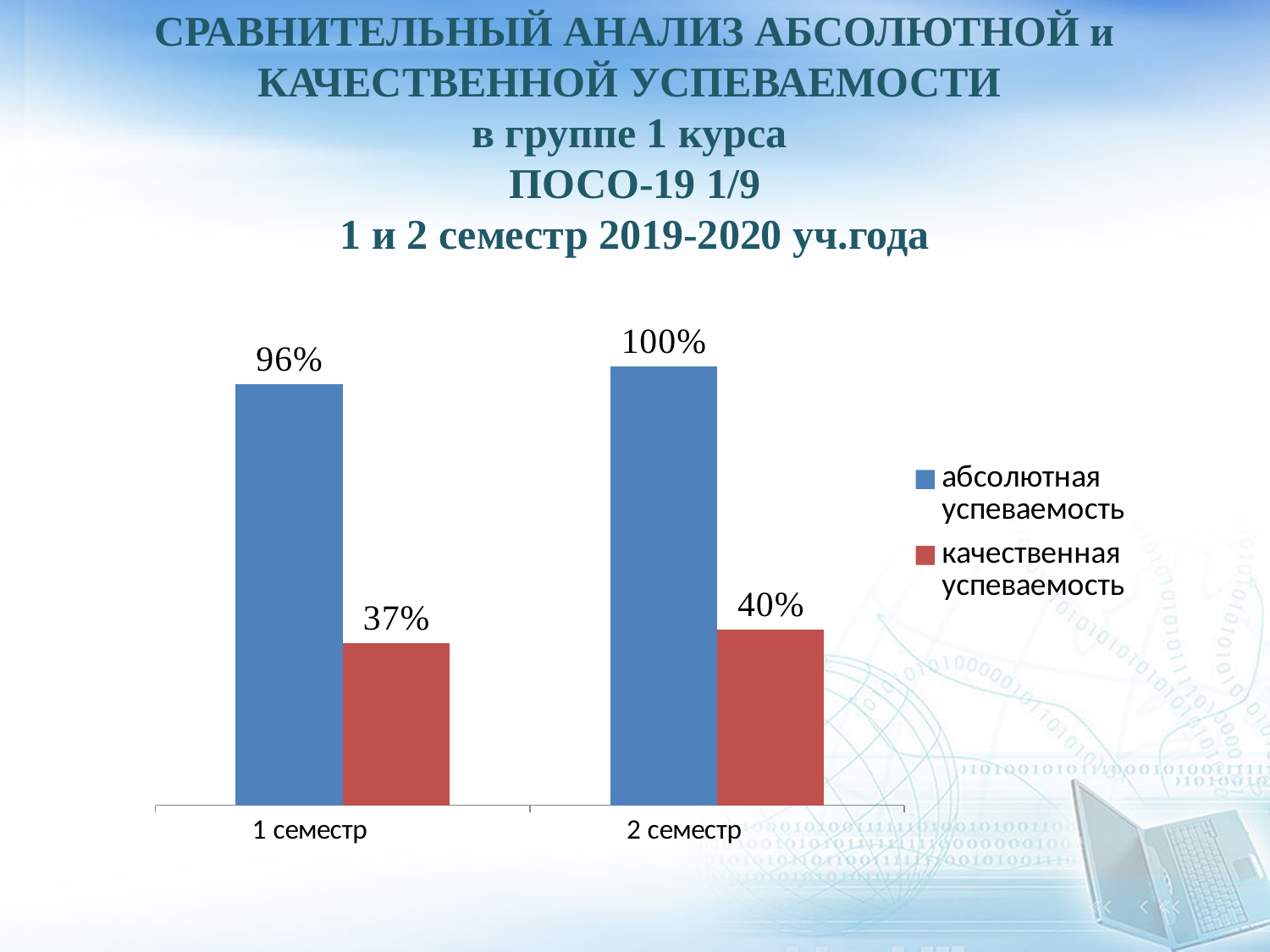
What is the value of абсолютная успеваемость for 2 семестр? 100% By how much did качественная успеваемость change from 1 семестр to 2 семестр? 3% What is the value of качественная успеваемость for 2 семестр? 40% How many categories are shown on the x axis? 2 Which is larger in 2 семестр: абсолютная успеваемость or качественная успеваемость? абсолютная успеваемость What is the value of качественная успеваемость for 1 семестр? 37% In which semester is качественная успеваемость lowest? 1 семестр What is the difference between абсолютная успеваемость and качественная успеваемость in 1 семестр? 59% In which semester is абсолютная успеваемость highest? 2 семестр What is the value of абсолютная успеваемость for 1 семестр? 96% How many series does the legend list? 2 What kind of chart is shown on the slide? bar chart